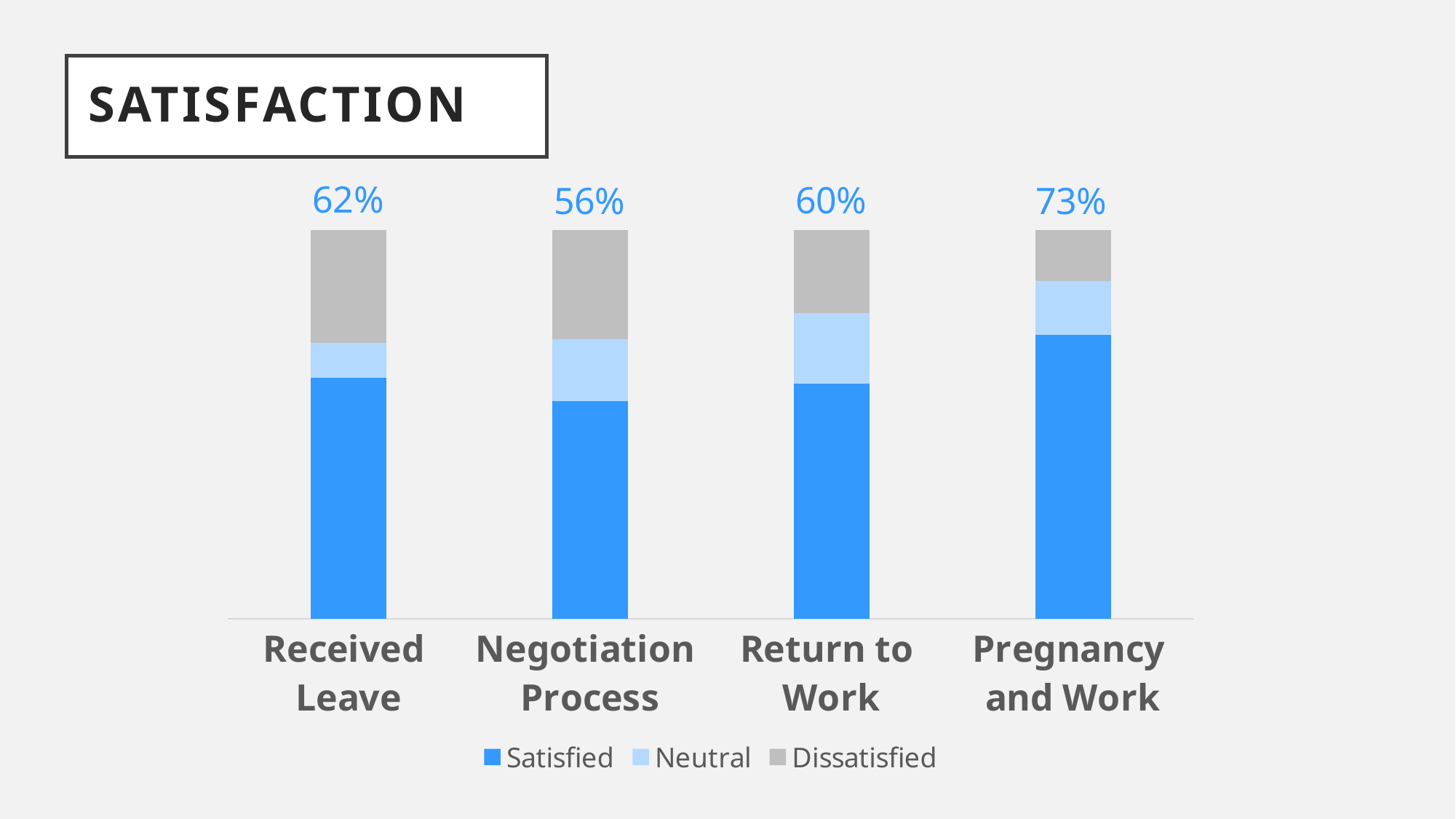
What value is labelled above the Pregnancy and Work bar? 73% Which category has the lowest labelled percentage? Negotiation Process How many categories are shown on the x axis? 4 Which has a larger labelled percentage, Received Leave or Return to Work? Received Leave What kind of chart is shown on the slide? Stacked bar chart Which legend entry is shown in grey? Dissatisfied What is the difference between the labelled percentages for Pregnancy and Work and Negotiation Process? 17% What value is labelled above the Negotiation Process bar? 56% How many series does the legend list? 3 Which category has the highest labelled percentage? Pregnancy and Work What value is labelled above the Received Leave bar? 62% What value is labelled above the Return to Work bar? 60%